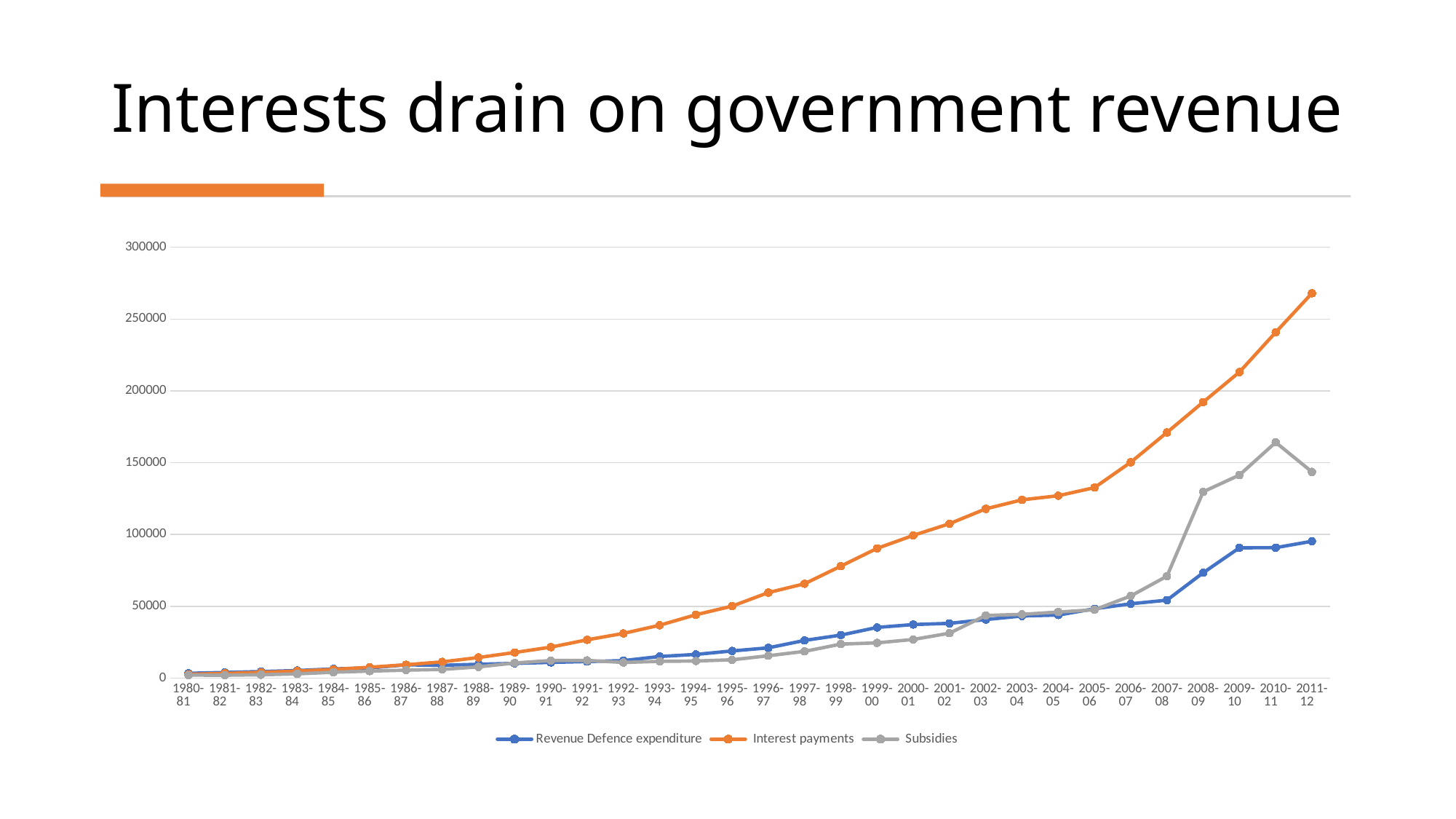
Is the value for Interest payments in 2005-06 greater or less than 100000? greater How many fiscal years are plotted along the x axis? 32 Is the value for Interest payments in 2011-12 greater or less than 250000? greater Do Interest payments generally rise or fall from 1980-81 to 2011-12? rise How many series does the legend list? 3 Is the value for Revenue Defence expenditure in 2011-12 greater or less than 100000? less Which series has the highest value in 2011-12? Interest payments What kind of chart is shown on the slide? line chart What is the title of the slide? Interests drain on government revenue In which year does the Subsidies series reach its highest value? 2010-11 In 2008-09, which is larger: Subsidies or Revenue Defence expenditure? Subsidies